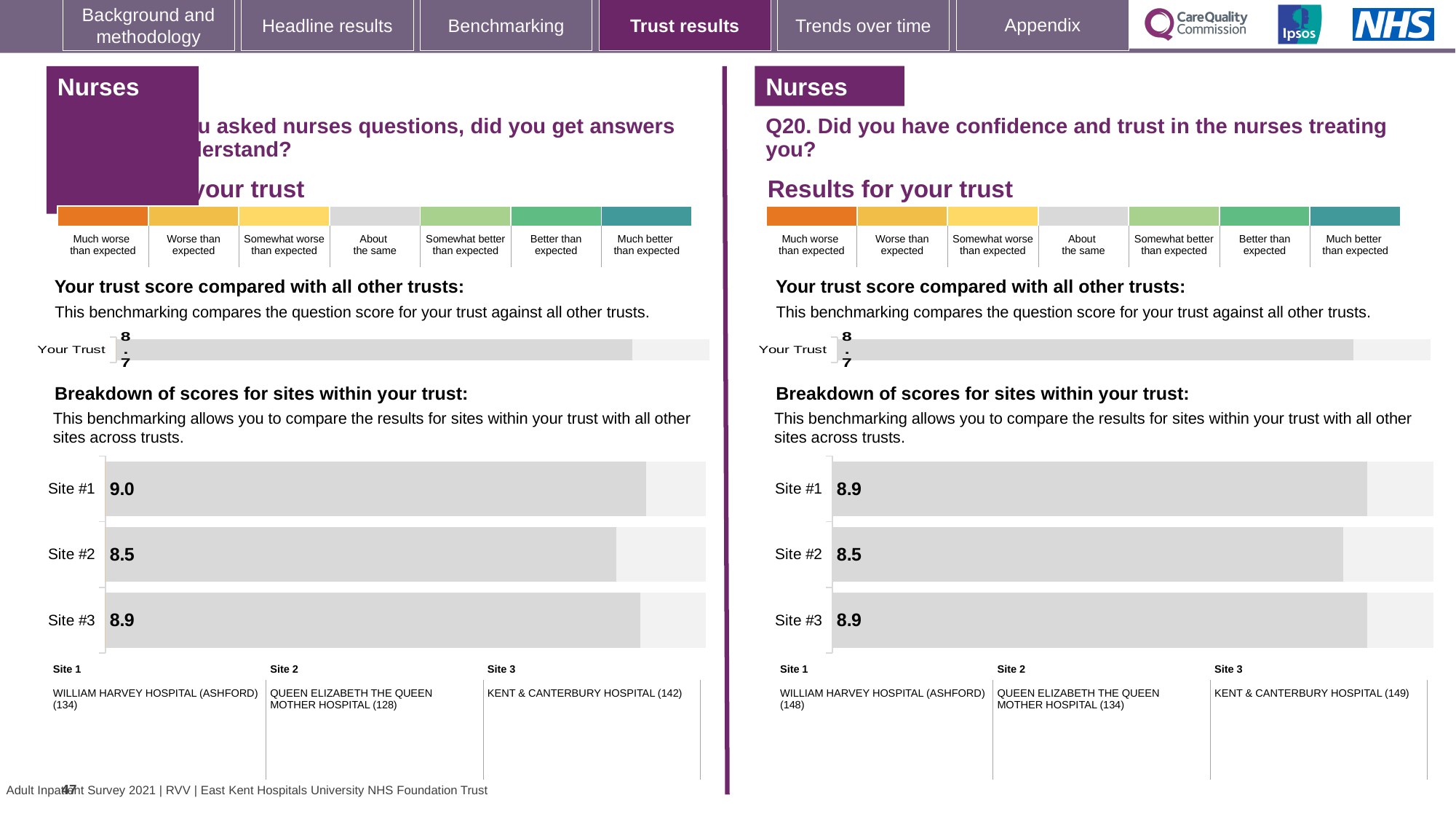
On the Q20 site breakdown chart on the right, what is the score for Site #2? 8.5 On the Q20 site breakdown chart on the right, what is the score for Site #3? 8.9 On the Q20 site breakdown chart on the right, what is the difference between the scores for Site #1 and Site #2? 0.4 On the left-hand site breakdown chart, what is the score for Site #1? 9.0 On the left-hand site breakdown chart, what is the score for Site #2? 8.5 On the left-hand site breakdown chart, what is the difference between the scores for Site #1 and Site #2? 0.5 On the left-hand site breakdown chart, which site has the lowest score? Site #2 On the Q20 site breakdown chart on the right, which site has the lowest score? Site #2 How many sites are shown on the left-hand site breakdown chart? 3 On the Q20 site breakdown chart on the right, is the score for Site #1 larger or smaller than the score for Site #2? larger On the left-hand site breakdown chart, which site has the highest score? Site #1 What kind of chart is the Q20 site breakdown chart on the right? bar chart